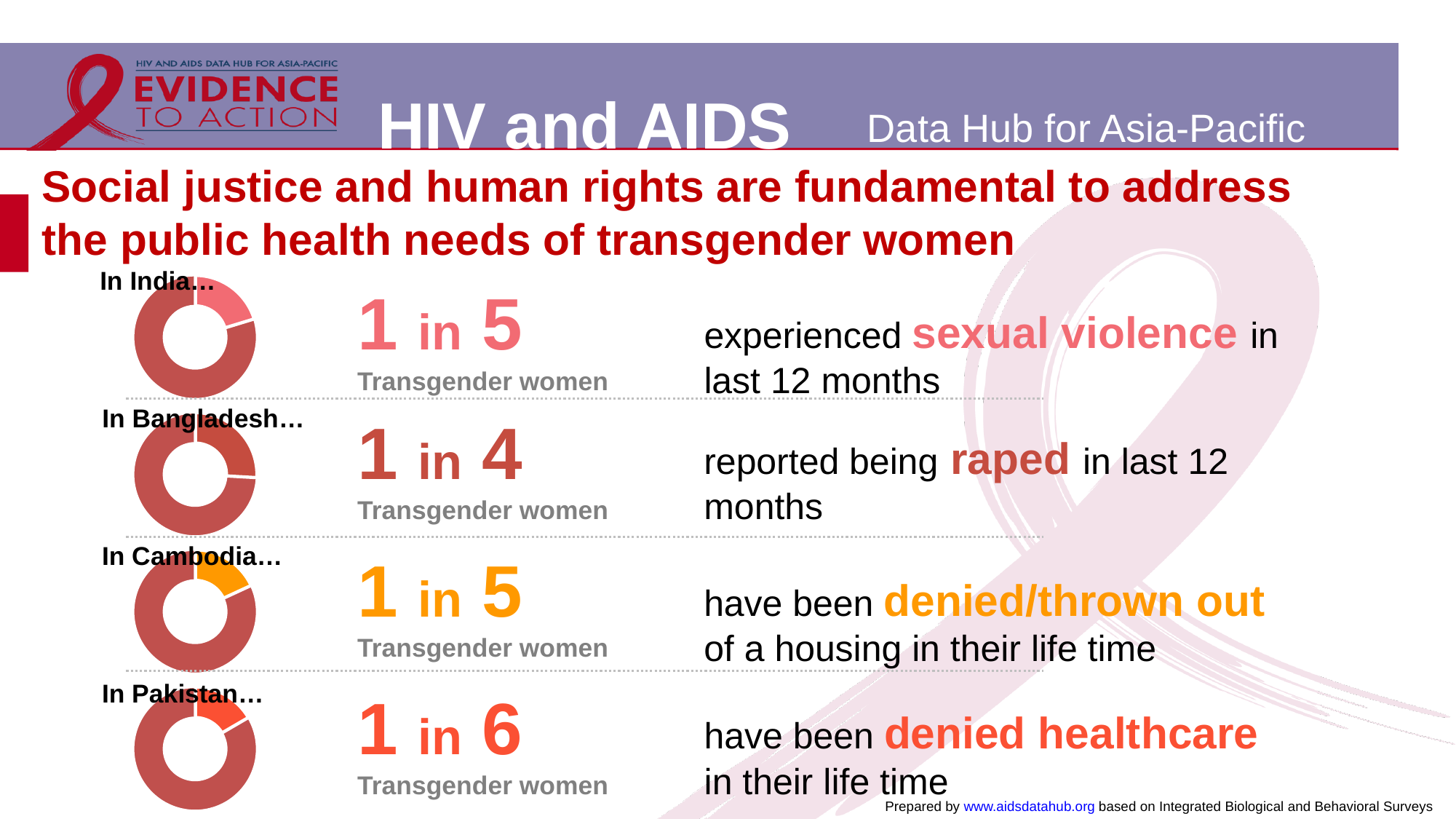
What colour is the highlighted slice in the Cambodia chart? Orange How many donut charts are shown on the slide? 4 In the Bangladesh chart, what proportion of transgender women reported being raped in the last 12 months? 1 in 4 In the Cambodia chart, what proportion of transgender women have been denied/thrown out of housing in their lifetime? 1 in 5 Which country's chart shows the smallest highlighted share of transgender women? Pakistan In the India chart, what proportion of transgender women experienced sexual violence in the last 12 months? 1 in 5 Which chart shows a larger highlighted share, Bangladesh or Pakistan? Bangladesh Which chart shows a larger highlighted share, Bangladesh or India? Bangladesh In the Pakistan chart, what proportion of transgender women have been denied healthcare in their lifetime? 1 in 6 Which countries are shown in the four donut charts, from top to bottom? India, Bangladesh, Cambodia, Pakistan What kind of chart is used for each country on the slide? Donut (pie) chart Which country's chart shows the largest highlighted share of transgender women? Bangladesh